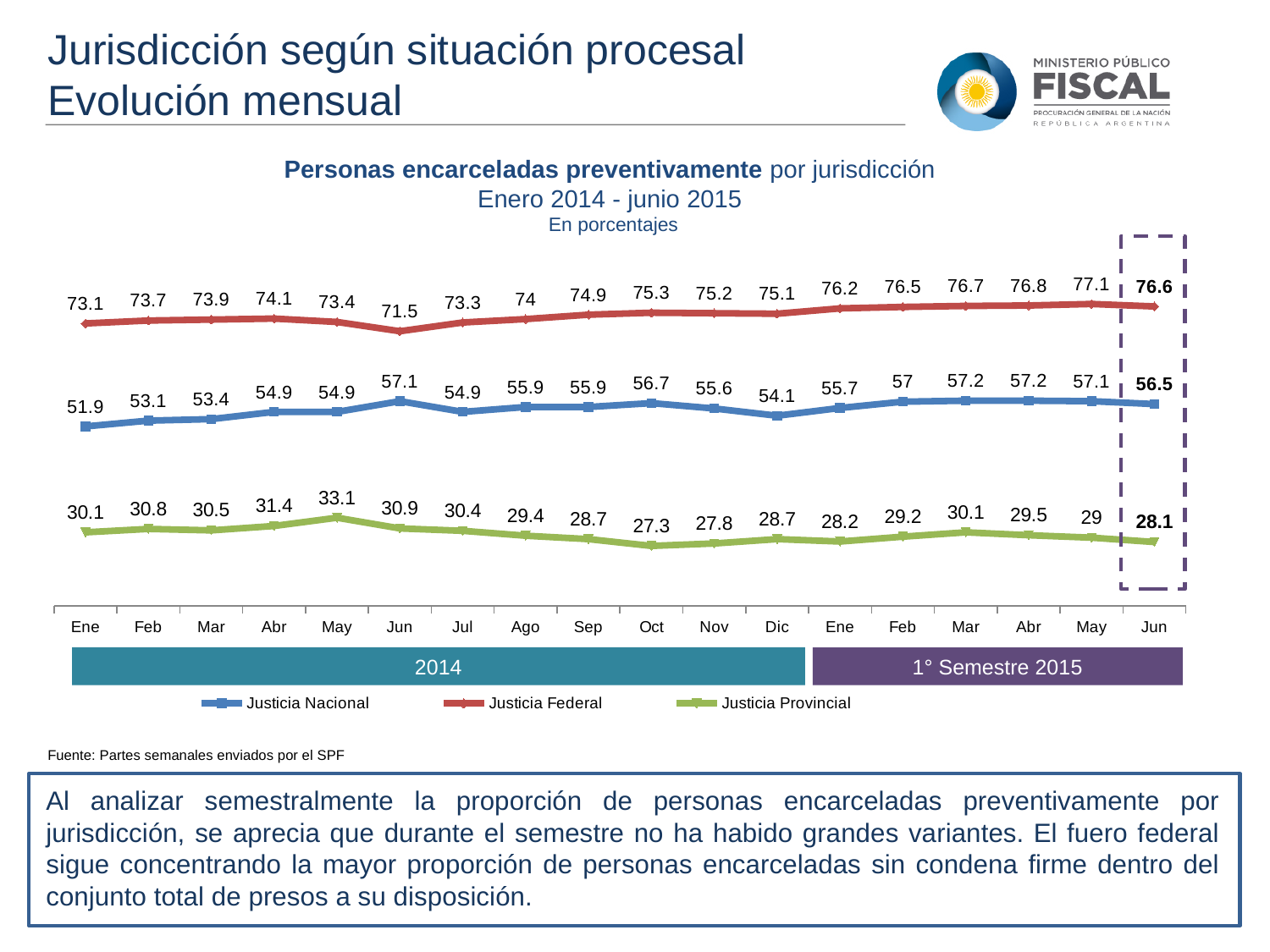
Which series has the higher value in Oct 2014, Justicia Nacional or Justicia Provincial? Justicia Nacional What is the difference between the Justicia Federal value in May 2015 and in Ene 2014? 4 What type of chart is shown on the slide? Line chart How many monthly data points are plotted for each series? 18 What is the value for Justicia Provincial in May 2014? 33.1 In which month is the Justicia Provincial value highest? May 2014 Which colour is used for the Justicia Provincial line? Green In which month is the Justicia Federal value lowest? Jun 2014 What is the value for Justicia Nacional in Ene 2014? 51.9 Does the Justicia Federal series generally rise or fall from Jun 2014 to May 2015? Rise What is the value for Justicia Federal in Jun 2015? 76.6 How many series does the legend list? 3